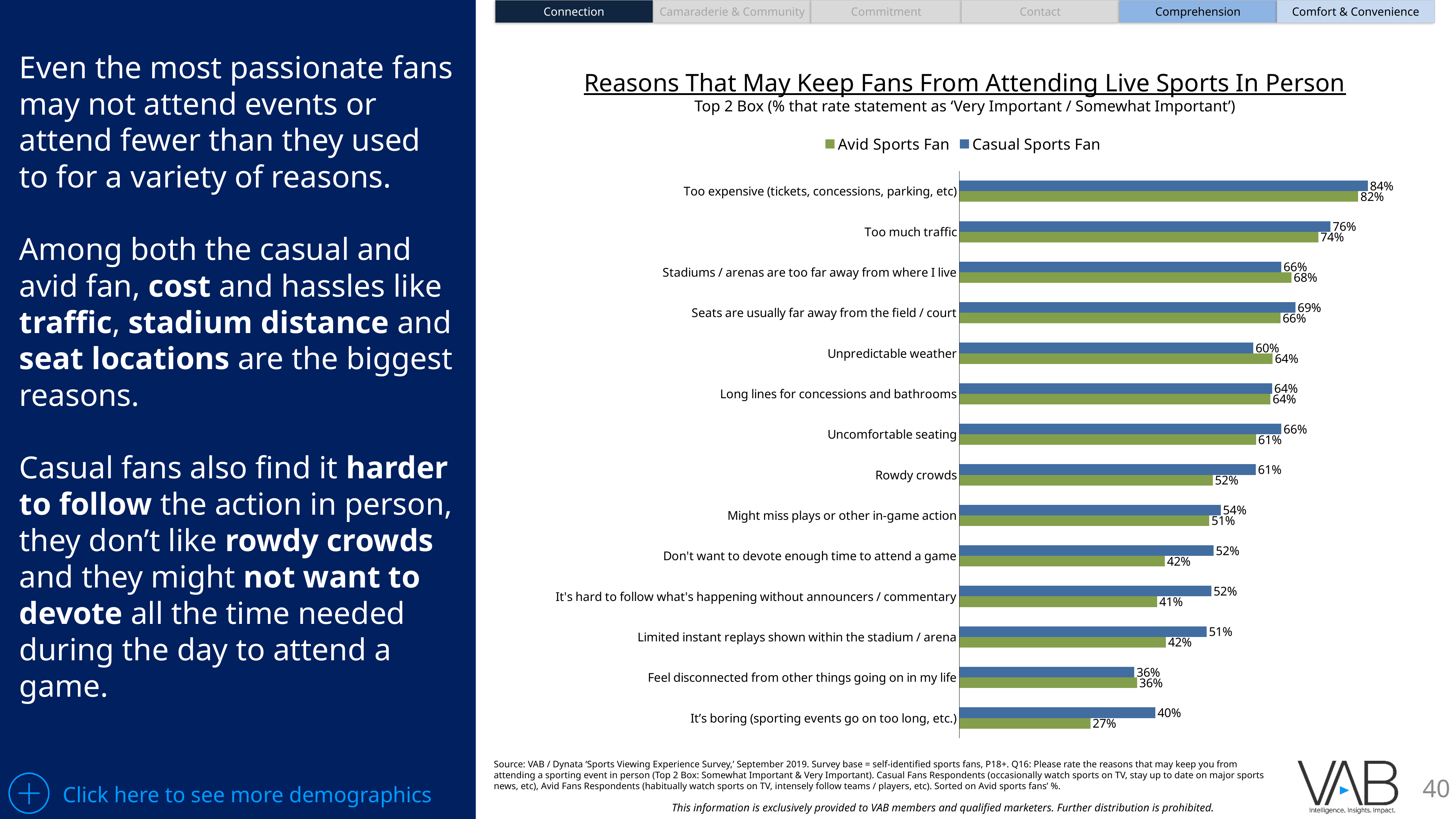
How many reasons (categories) are plotted in the chart? 14 What percentage of Casual Sports Fans rate 'Too expensive (tickets, concessions, parking, etc)' as important? 84% What is the difference between the Casual Sports Fan and Avid Sports Fan values for 'It's boring (sporting events go on too long, etc.)'? 13% Which reason has the lowest Casual Sports Fan percentage? Feel disconnected from other things going on in my life For 'Don't want to devote enough time to attend a game', which series has the larger value, Avid Sports Fan or Casual Sports Fan? Casual Sports Fan How many series does the legend list? 2 What is the Avid Sports Fan value for 'It's boring (sporting events go on too long, etc.)'? 27% What kind of chart is shown on the slide? Bar chart What is the Avid Sports Fan value for 'Unpredictable weather'? 64% Which reason has the highest Avid Sports Fan percentage? Too expensive (tickets, concessions, parking, etc) Which colour represents the Avid Sports Fan series in the chart? Green What is the difference between the Casual Sports Fan and Avid Sports Fan values for 'Rowdy crowds'? 9%